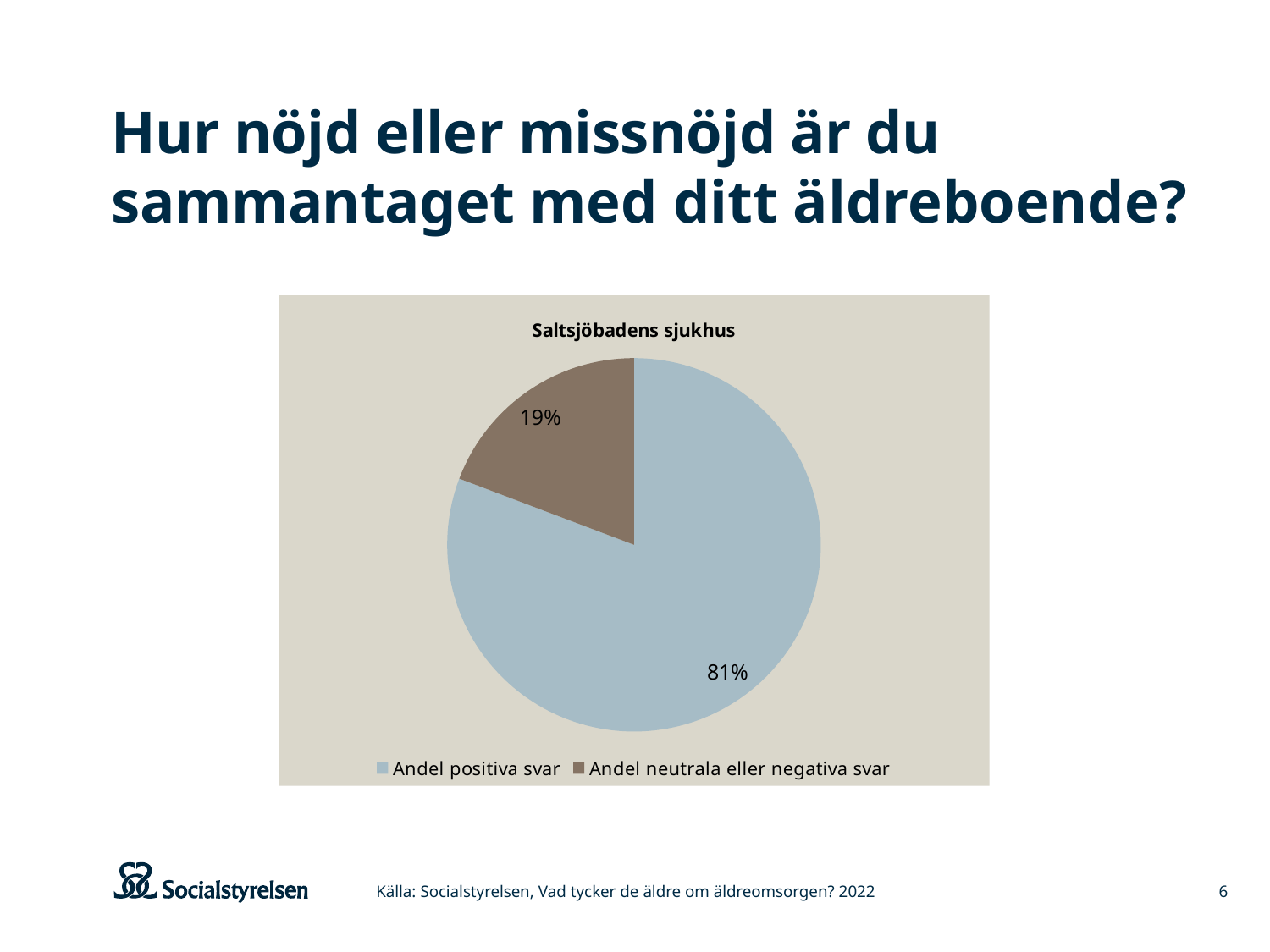
Which is larger, 'Andel positiva svar' or 'Andel neutrala eller negativa svar'? Andel positiva svar What kind of chart is shown on the slide? pie chart What colour is the 'Andel positiva svar' slice? light blue What is the total of the two slices shown? 100% Which slice is the smallest? Andel neutrala eller negativa svar What is the chart's title? Saltsjöbadens sjukhus How many slices does the pie chart have? 2 What is the difference in percentage points between 'Andel positiva svar' and 'Andel neutrala eller negativa svar'? 62 percentage points How many entries does the legend list? 2 Which slice is the largest? Andel positiva svar What share of the pie is 'Andel neutrala eller negativa svar'? 19% What share of the pie is 'Andel positiva svar'? 81%